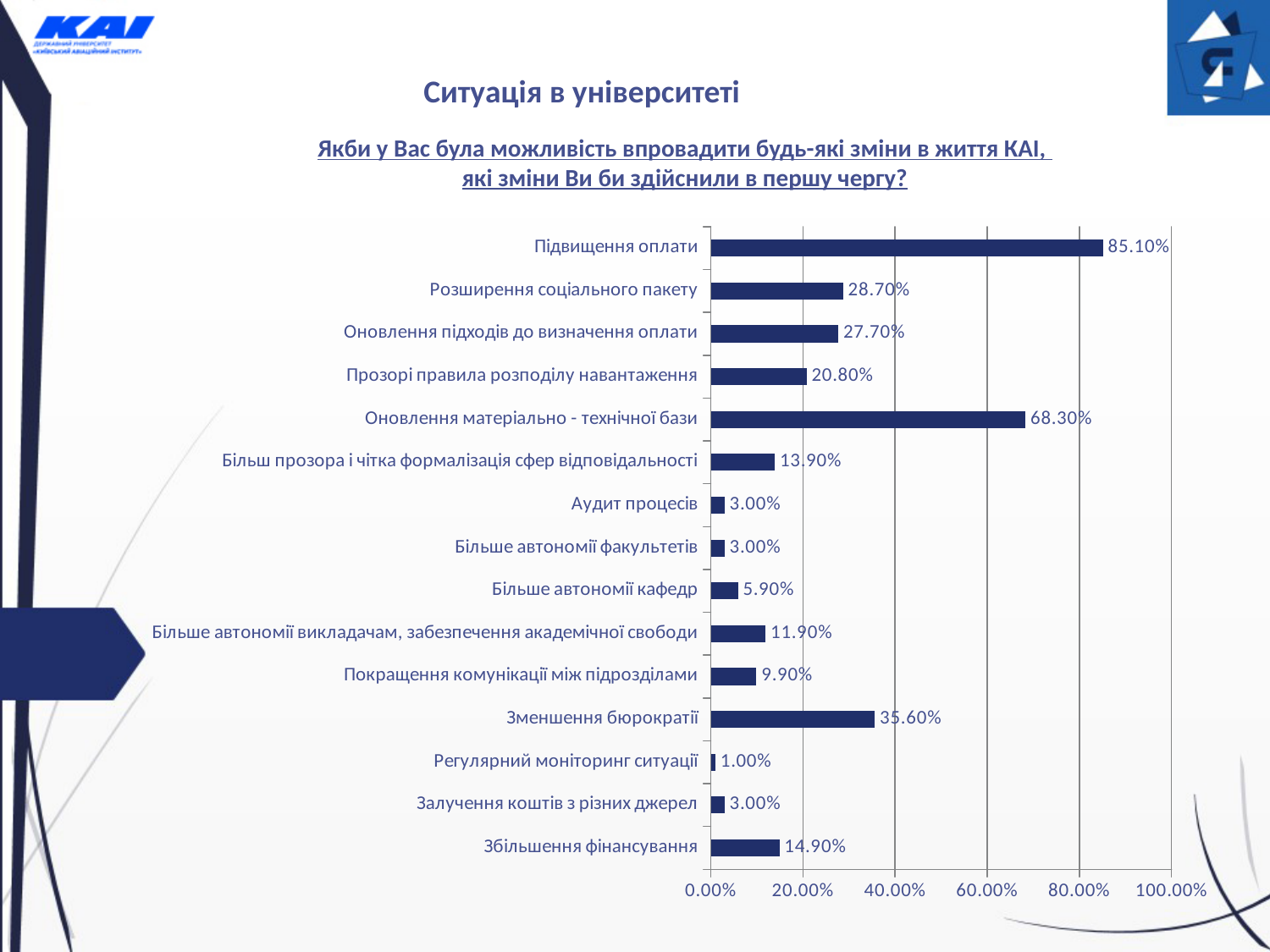
Is the value for "Оновлення матеріально - технічної бази" greater or less than 60.00%? greater What is the value for "Оновлення матеріально - технічної бази"? 68.30% What is the value for "Підвищення оплати"? 85.10% What is the value for "Зменшення бюрократії"? 35.60% What is the difference between the values for "Підвищення оплати" and "Оновлення матеріально - технічної бази"? 16.80% Which is larger: the value for "Зменшення бюрократії" or for "Розширення соціального пакету"? Зменшення бюрократії What is the value for "Збільшення фінансування"? 14.90% Which category has the lowest value? Регулярний моніторинг ситуації What kind of chart is shown on the slide? bar chart What is the maximum value shown on the horizontal axis of the chart? 100.00% Which category has the highest value? Підвищення оплати How many categories are plotted in the chart? 15